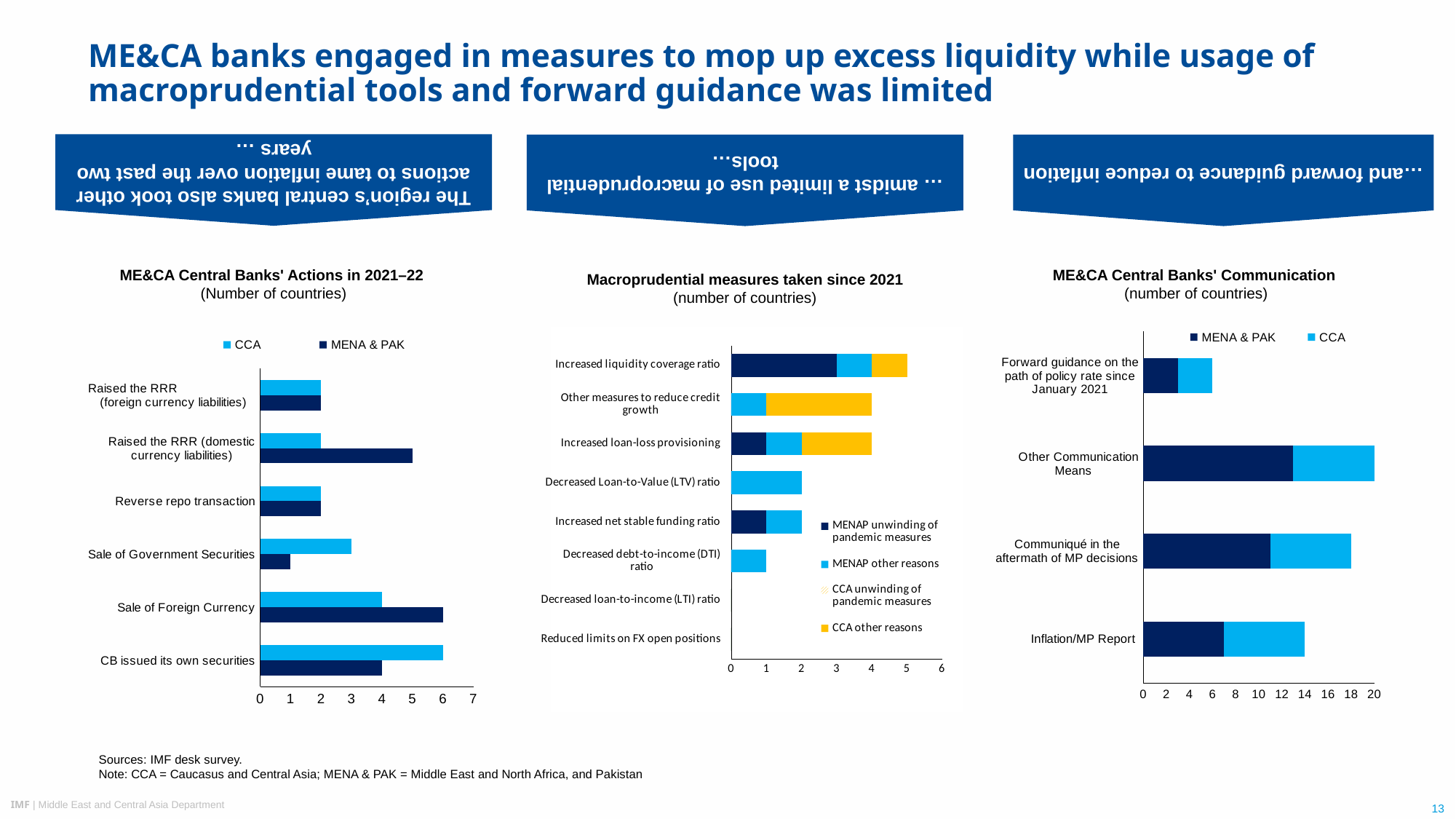
In the "Macroprudential measures taken since 2021" chart, how many series does the legend list? 4 In the "ME&CA Central Banks' Actions in 2021–22" chart, for "Raised the RRR (domestic currency liabilities)", which series has the larger value, CCA or MENA & PAK? MENA & PAK In the "Macroprudential measures taken since 2021" chart, which measure has the longest total bar? Increased liquidity coverage ratio In the "ME&CA Central Banks' Actions in 2021–22" chart, how many series does the legend list? 2 In the "ME&CA Central Banks' Communication" chart, which communication category has the longest total bar? Other Communication Means In the "ME&CA Central Banks' Actions in 2021–22" chart, which category has the highest CCA value? CB issued its own securities In the "ME&CA Central Banks' Actions in 2021–22" chart, how many action categories are shown? 6 In the "Macroprudential measures taken since 2021" chart, is the total for "Increased loan-loss provisioning" greater or less than 3? greater What type of chart is "ME&CA Central Banks' Actions in 2021–22"? bar chart In the "ME&CA Central Banks' Actions in 2021–22" chart, which category has the lowest MENA & PAK value? Sale of Government Securities In the "ME&CA Central Banks' Communication" chart, is the MENA & PAK value for "Communiqué in the aftermath of MP decisions" greater or less than 10? greater In the "ME&CA Central Banks' Actions in 2021–22" chart, is the MENA & PAK value for "Sale of Foreign Currency" greater or less than 5? greater